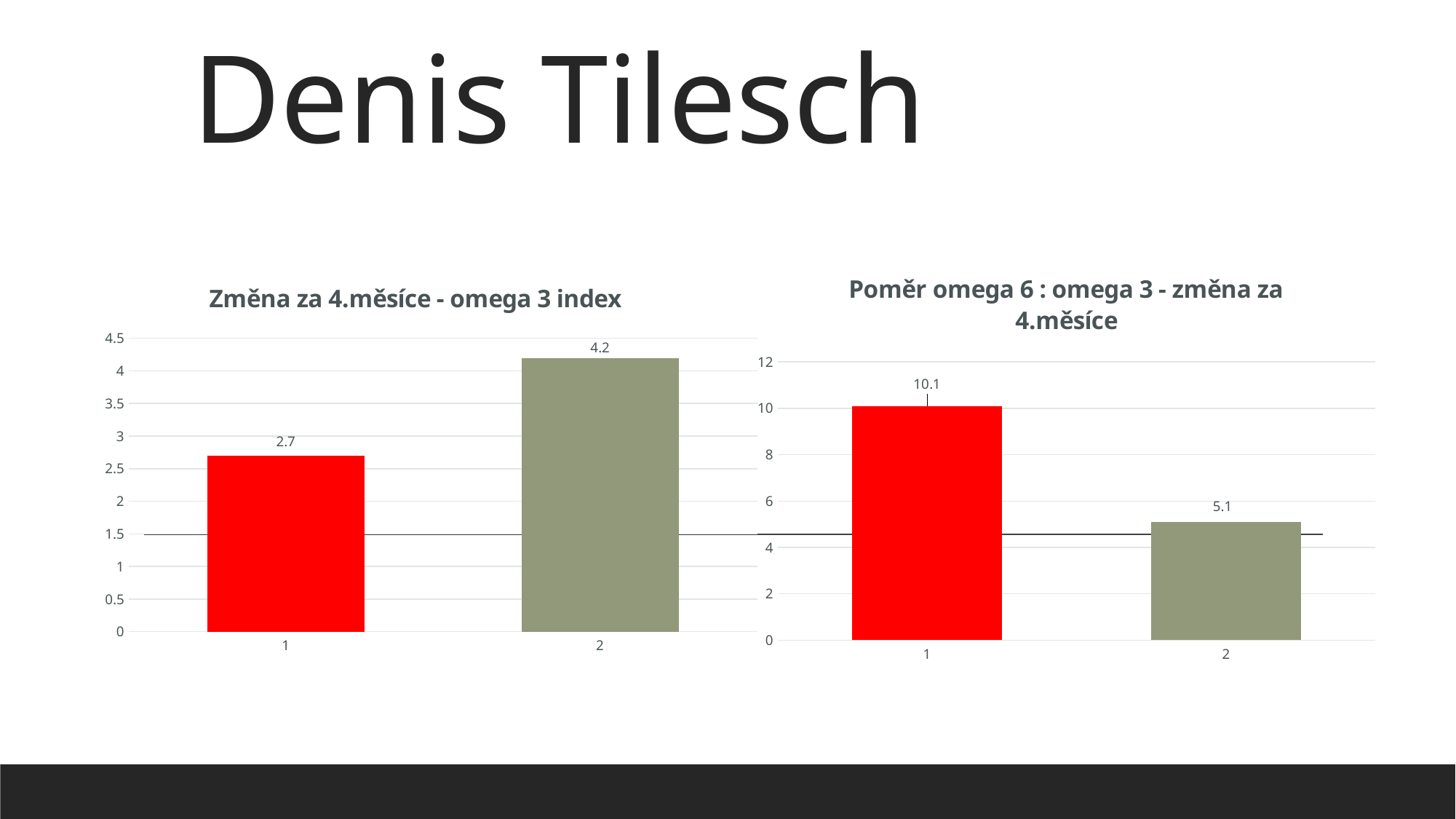
In the chart 'Změna za 4.měsíce - omega 3 index', what is the value for category 1? 2.7 In the chart 'Změna za 4.měsíce - omega 3 index', is the value for category 1 greater or less than 3? less In the chart 'Poměr omega 6 : omega 3 - změna za 4.měsíce', which category has the larger value, 1 or 2? 1 How many bars are shown in the chart 'Změna za 4.měsíce - omega 3 index'? 2 In the chart 'Poměr omega 6 : omega 3 - změna za 4.měsíce', what is the difference between the values for category 1 and category 2? 5 In the chart 'Změna za 4.měsíce - omega 3 index', what is the value for category 2? 4.2 In the chart 'Poměr omega 6 : omega 3 - změna za 4.měsíce', what is the value for category 2? 5.1 In the chart 'Změna za 4.měsíce - omega 3 index', what is the difference between the values for category 2 and category 1? 1.5 In the chart 'Poměr omega 6 : omega 3 - změna za 4.měsíce', which category has the lowest value? 2 What type of chart is the chart on the right of the slide? bar chart In the chart 'Poměr omega 6 : omega 3 - změna za 4.měsíce', what is the value for category 1? 10.1 In the chart 'Změna za 4.měsíce - omega 3 index', which category has the highest value? 2